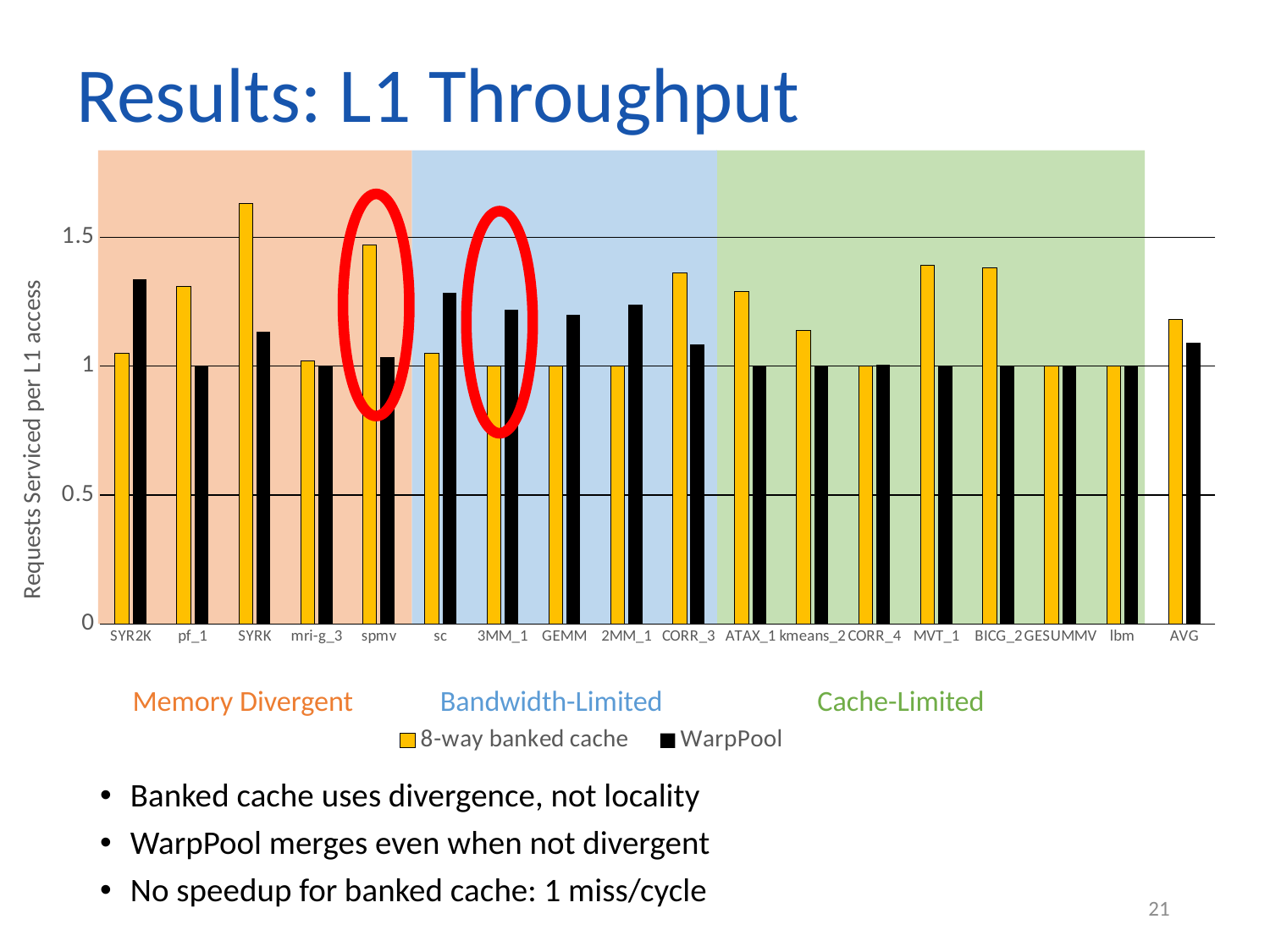
What kind of chart is shown on the slide? bar chart Which category has the highest value for the 8-way banked cache series? SYRK For CORR_3, which series has the larger value: 8-way banked cache or WarpPool? 8-way banked cache How many categories are shown along the x axis? 18 For sc, which series has the larger value: 8-way banked cache or WarpPool? WarpPool Is the 8-way banked cache value for SYRK greater or less than 1.5? greater How many series does the legend list? 2 Is the 8-way banked cache value for MVT_1 greater or less than 1.5? less For SYR2K, which series has the larger value: 8-way banked cache or WarpPool? WarpPool Is the WarpPool value for SYR2K greater or less than 1? greater What is the label of the y axis? Requests Serviced per L1 access What are the two series named in the legend? 8-way banked cache and WarpPool